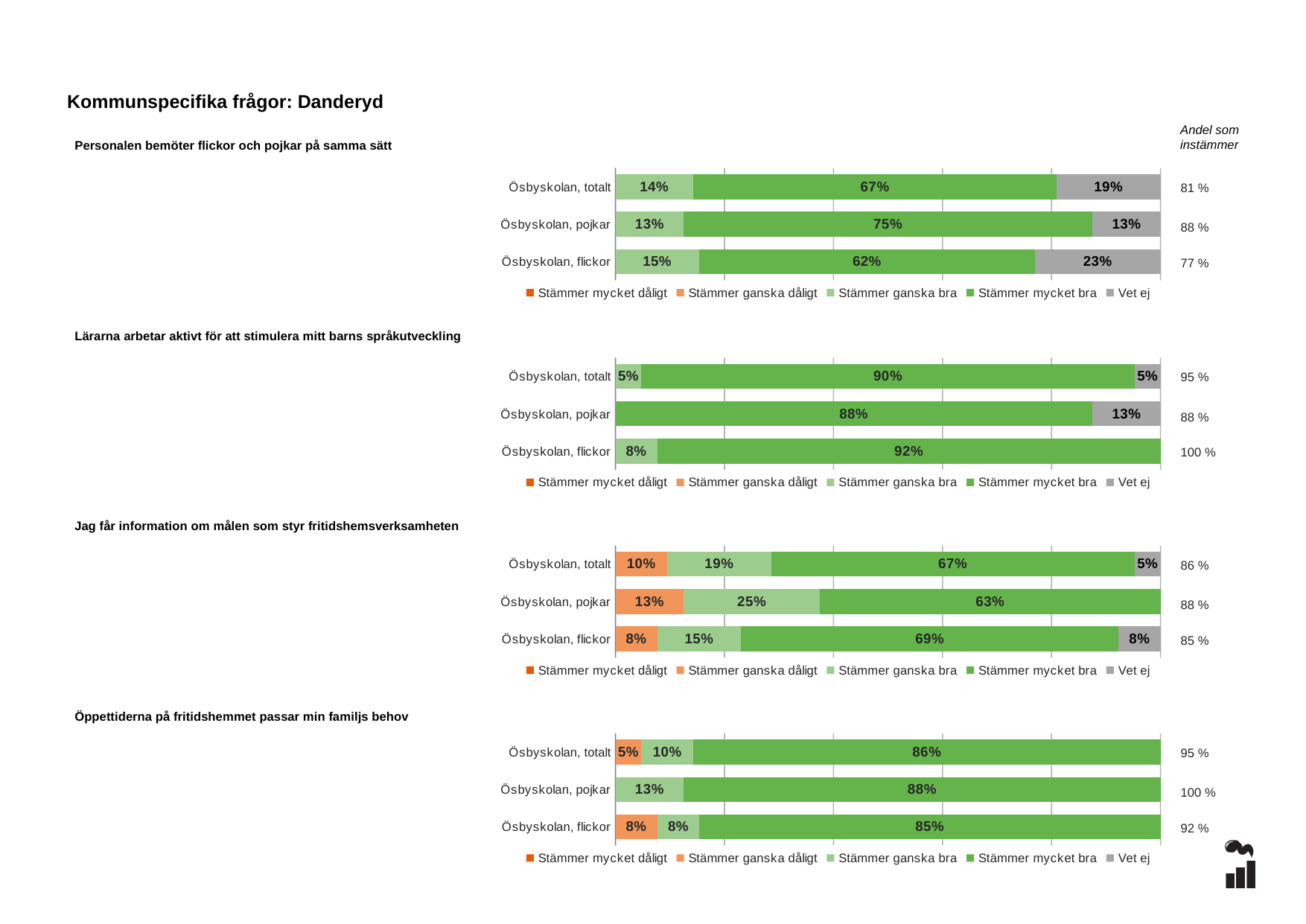
In the chart 'Personalen bemöter flickor och pojkar på samma sätt', which category has the highest 'Stämmer mycket bra' value? Ösbyskolan, pojkar What kind of chart is 'Öppettiderna på fritidshemmet passar min familjs behov'? Stacked bar chart In the chart 'Lärarna arbetar aktivt för att stimulera mitt barns språkutveckling', what is the difference between the 'Stämmer mycket bra' values for Ösbyskolan, flickor and Ösbyskolan, pojkar? 4 percentage points How many series does the legend of the chart 'Personalen bemöter flickor och pojkar på samma sätt' list? 5 In the chart 'Jag får information om målen som styr fritidshemsverksamheten', which category has the lowest 'Stämmer mycket bra' value? Ösbyskolan, pojkar In the chart 'Öppettiderna på fritidshemmet passar min familjs behov', how many categories are shown? 3 In the chart 'Personalen bemöter flickor och pojkar på samma sätt', what is the 'Vet ej' value for Ösbyskolan, flickor? 23% In the chart 'Jag får information om målen som styr fritidshemsverksamheten', is the 'Stämmer ganska bra' value larger for Ösbyskolan, pojkar or Ösbyskolan, flickor? Ösbyskolan, pojkar In the chart 'Öppettiderna på fritidshemmet passar min familjs behov', what is the 'Stämmer mycket bra' value for Ösbyskolan, flickor? 85% In the chart 'Jag får information om målen som styr fritidshemsverksamheten', what is the 'Stämmer ganska dåligt' value for Ösbyskolan, pojkar? 13% In the chart 'Lärarna arbetar aktivt för att stimulera mitt barns språkutveckling', what is the 'Stämmer mycket bra' value for Ösbyskolan, totalt? 90% In the chart 'Personalen bemöter flickor och pojkar på samma sätt', what is the 'Stämmer mycket bra' value for Ösbyskolan, pojkar? 75%